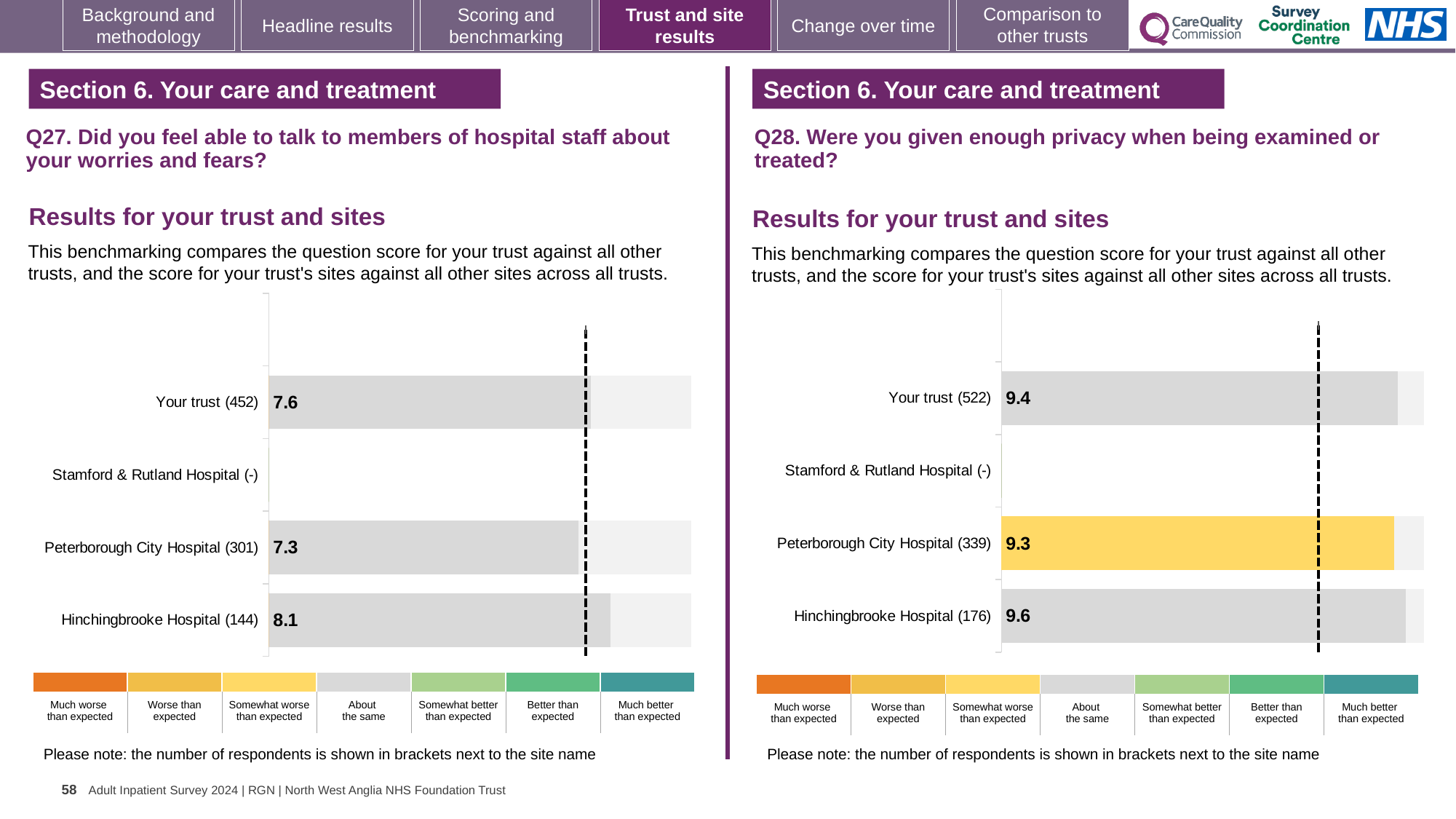
On the Q28 chart (right), what is the score for Peterborough City Hospital? 9.3 On the Q27 chart (left), which site or trust has the lowest score? Peterborough City Hospital On the Q28 chart (right), how many respondents are shown in brackets for Hinchingbrooke Hospital? 176 On the Q27 chart (left), what is the difference between the scores for Hinchingbrooke Hospital and Peterborough City Hospital? 0.8 On the Q27 chart (left), what is the score for Hinchingbrooke Hospital? 8.1 On the Q28 chart (right), which site or trust has the highest score? Hinchingbrooke Hospital On the Q27 chart (left), how many respondents are shown in brackets for Your trust? 452 On the Q28 chart (right), which site's bar is coloured yellow (somewhat worse than expected)? Peterborough City Hospital On the Q28 chart (right), which is larger: the score for Your trust or the score for Peterborough City Hospital? Your trust On the Q27 chart (left), what is the score for Your trust? 7.6 What kind of chart is used on the Q27 chart (left)? Bar chart On the Q28 chart (right), what is the difference between the scores for Hinchingbrooke Hospital and Your trust? 0.2